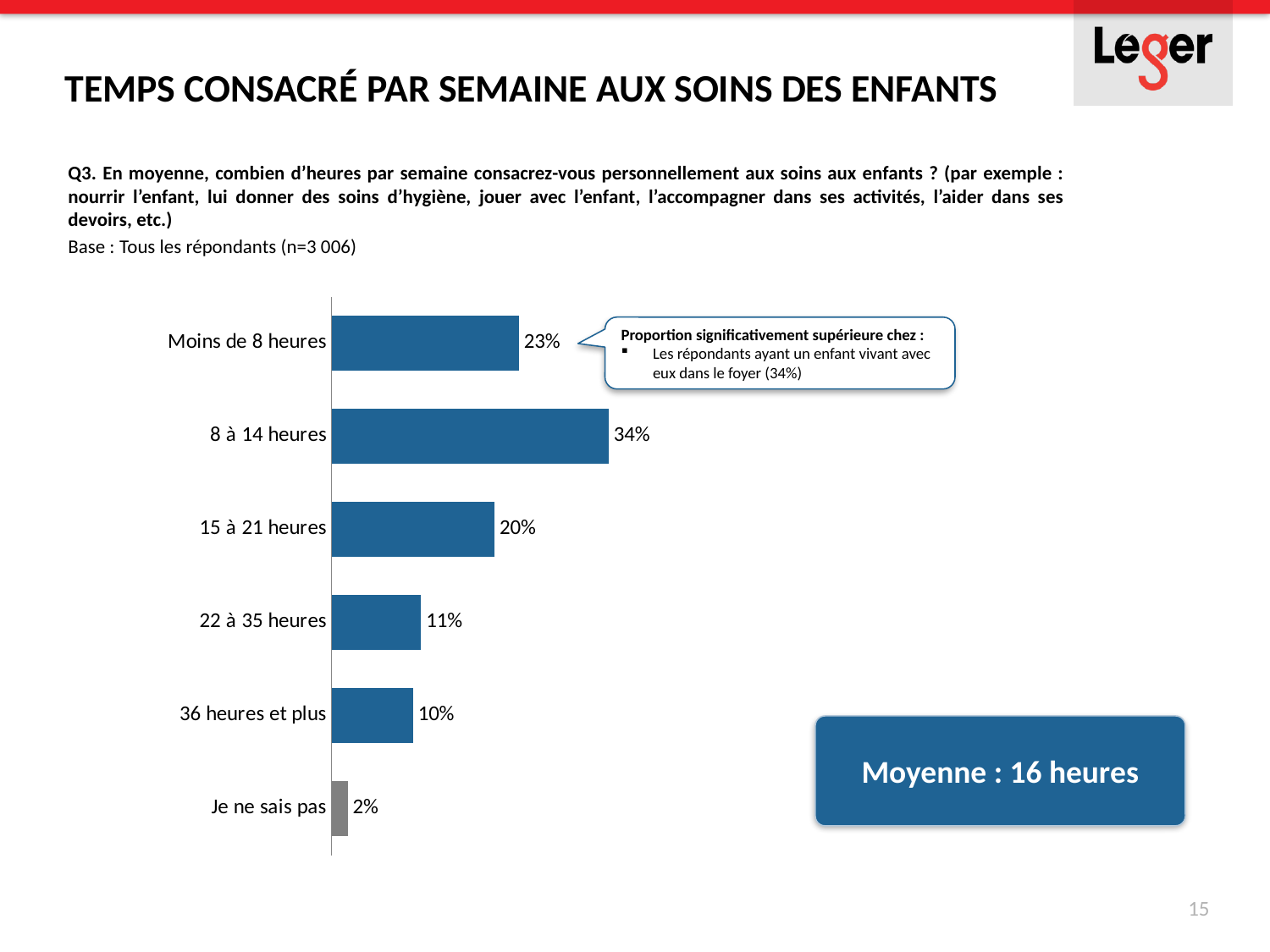
Which is larger, the value for "Moins de 8 heures" or the value for "15 à 21 heures"? Moins de 8 heures Which category has the lowest value? Je ne sais pas How many categories are shown in the chart? 6 What is the value for "8 à 14 heures"? 34% What is the value for "Je ne sais pas"? 2% What average (Moyenne) is stated in the box next to the chart? 16 heures What kind of chart is shown on the slide? Bar chart What is the difference between the values for "8 à 14 heures" and "15 à 21 heures"? 14% What is the value for "Moins de 8 heures"? 23% Which category has the highest value? 8 à 14 heures What is the value for "36 heures et plus"? 10% What is the difference between the values for "22 à 35 heures" and "36 heures et plus"? 1%